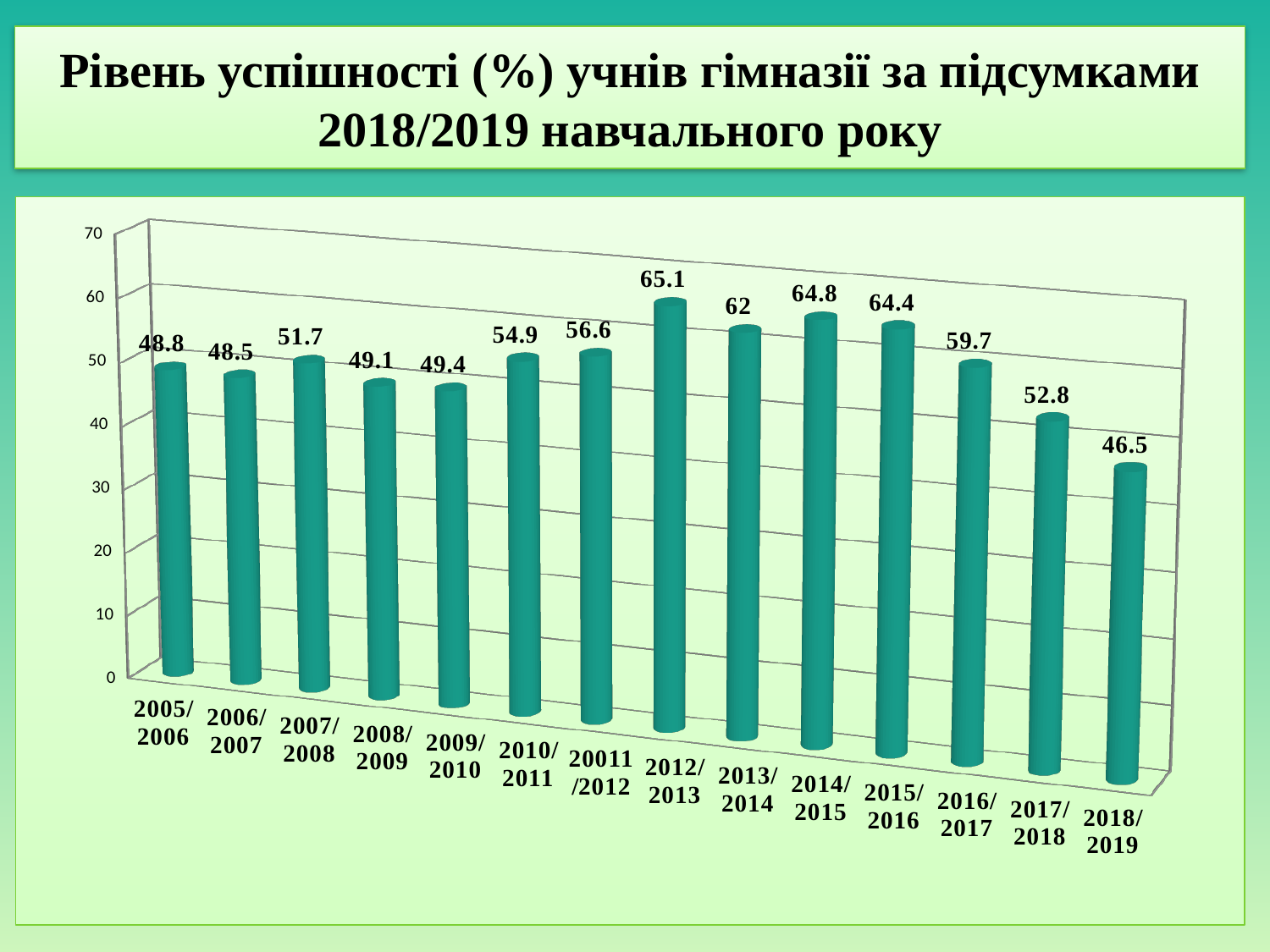
What is the value for 2007/2008? 51.7 Is the value for 2013/2014 greater or less than 60? greater Which school year has the lowest value? 2018/2019 What is the value for 2012/2013? 65.1 How many school years are shown on the chart? 14 What is the value for 2018/2019? 46.5 Do the values rise or fall from 2015/2016 to 2018/2019? fall Which is larger, the value for 2014/2015 or the value for 2015/2016? 2014/2015 What is the difference between the values for 2016/2017 and 2017/2018? 6.9 What is the difference between the values for 2012/2013 and 2018/2019? 18.6 What kind of chart is shown on the slide? bar chart Which school year has the highest value? 2012/2013